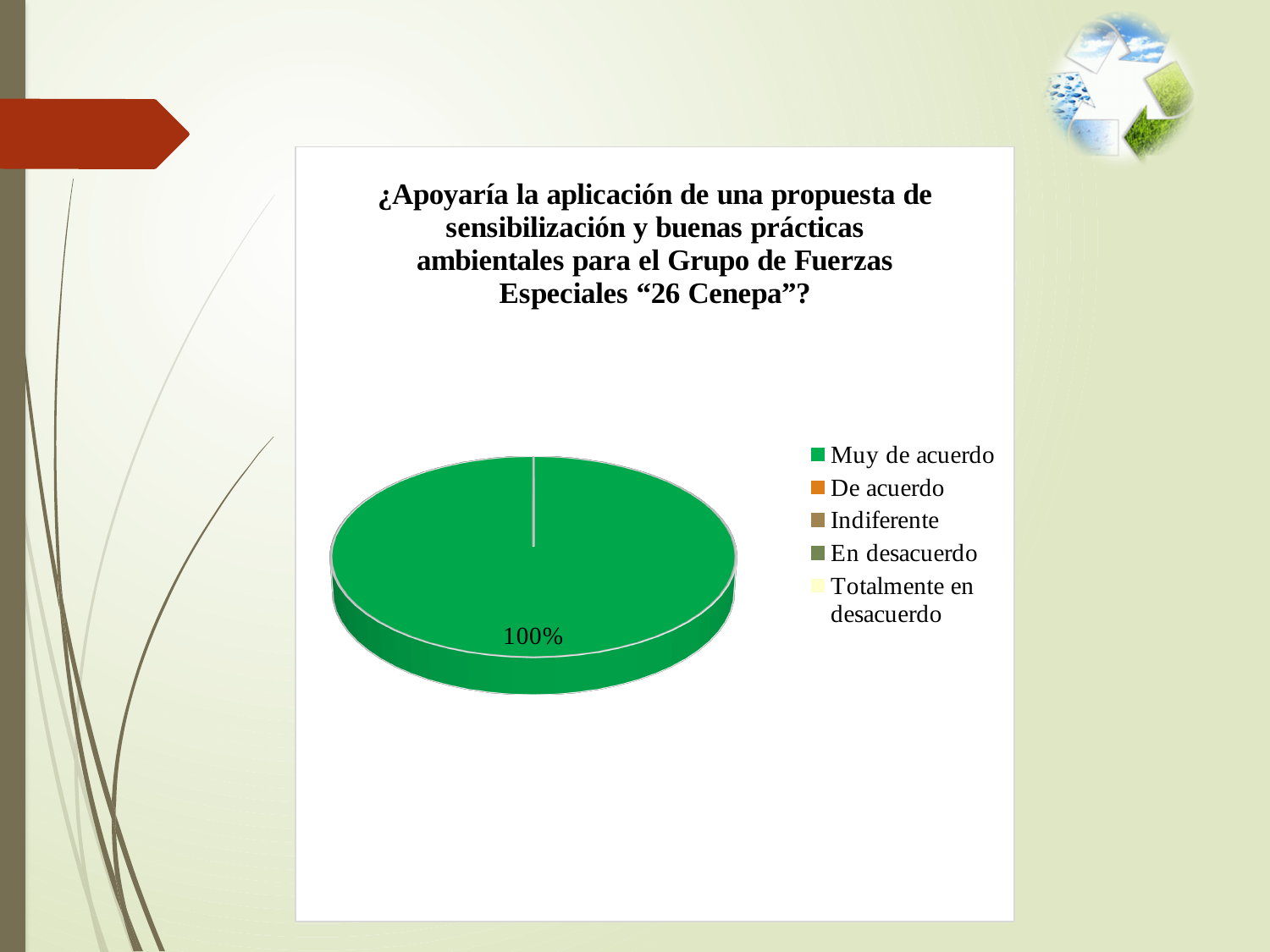
How many entries does the legend list? 5 Which category is shown in green in the legend? Muy de acuerdo What is the value printed on the pie chart? 100% Is the share for "Muy de acuerdo" greater or less than 50%? greater How many slices are visible in the pie chart? 1 Which is larger, the share for "Muy de acuerdo" or the share for "De acuerdo"? Muy de acuerdo What share of the pie does "Muy de acuerdo" represent? 100% What kind of chart is shown on the slide? pie chart Which category accounts for the largest share of the pie? Muy de acuerdo What is the last entry listed in the legend? Totalmente en desacuerdo